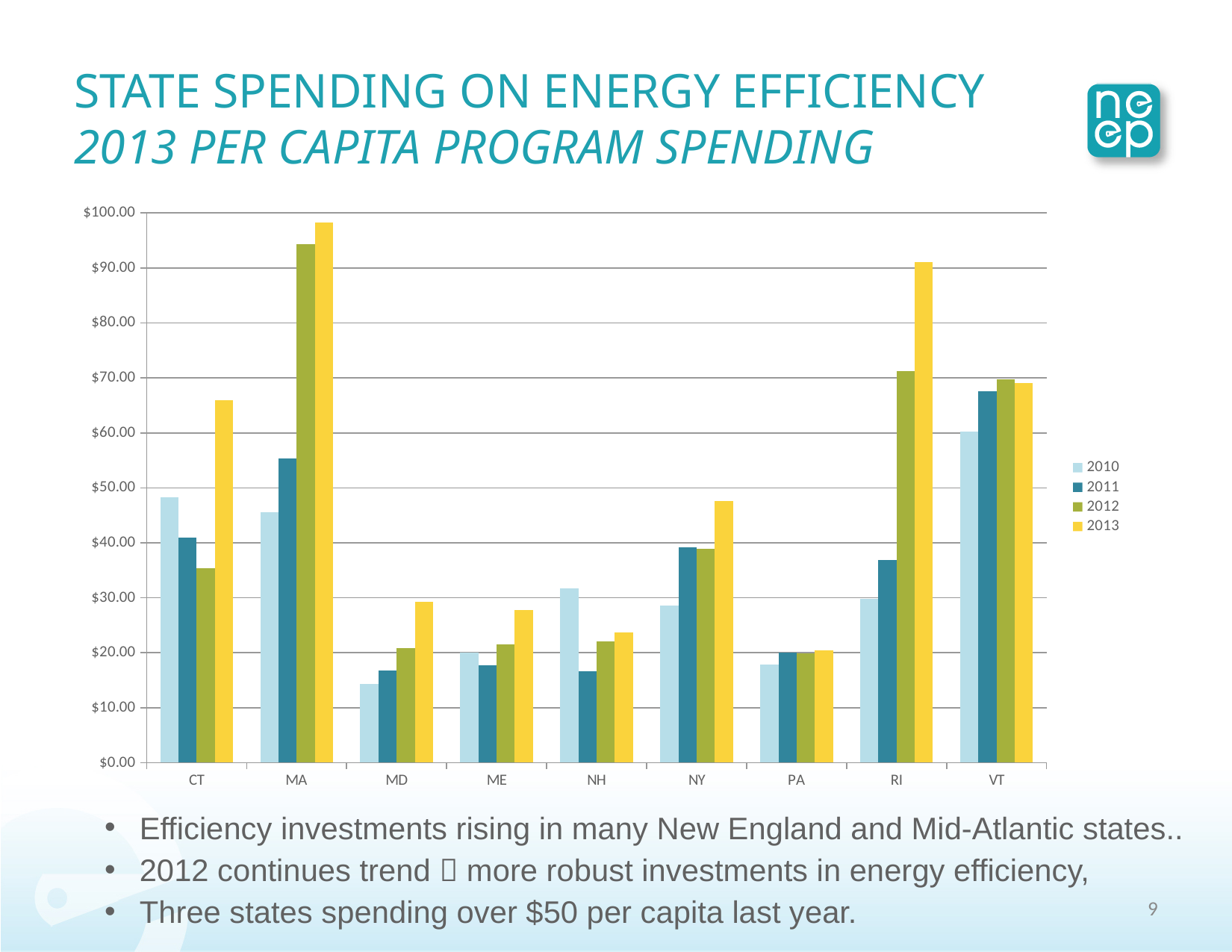
What colour represents the 2013 series in the legend? yellow Is the 2011 value for NH greater or less than $20.00? less Which is larger for CT, the 2010 value or the 2012 value? 2010 Which is larger, the 2013 value for RI or the 2013 value for VT? RI Which state has the highest 2013 per capita spending? MA Which state has the lowest 2010 per capita spending? MD Is the 2013 value for MA greater or less than $90.00? greater What kind of chart is shown on the slide? bar chart How many states are shown on the x axis? 9 Do the values for MD rise or fall from 2010 to 2013? rise Is the 2013 value for CT greater or less than $60.00? greater How many series does the legend list? 4